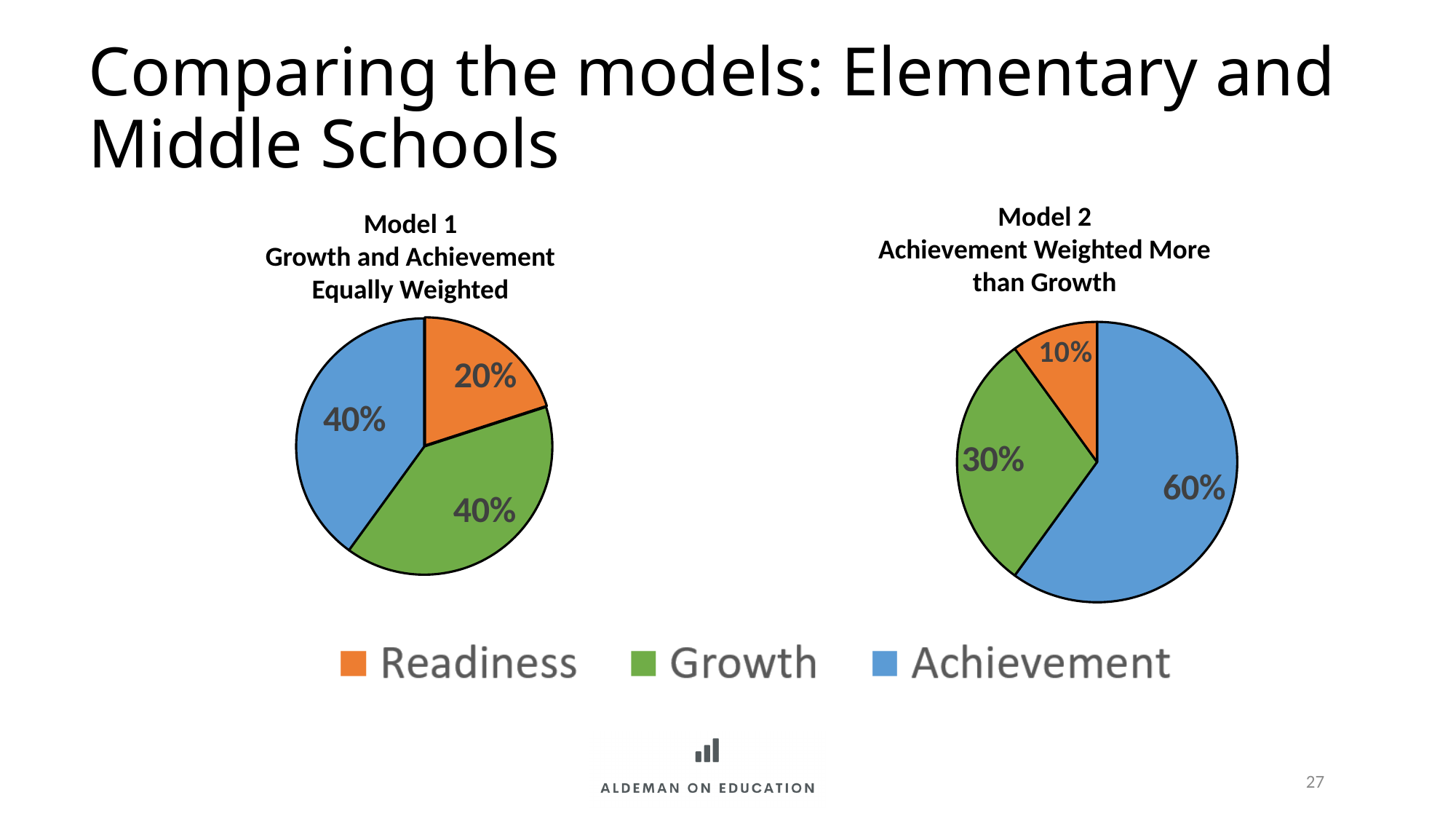
In the Model 1 pie chart, which category has the smallest slice? Readiness Which is larger: the Readiness share in Model 1 or the Readiness share in Model 2? Model 1 In the Model 2 pie chart, what share does Achievement have? 60% In the Model 2 pie chart, what is the difference between the Achievement and Growth shares? 30% What type of chart is used for Model 1 and Model 2? Pie chart In the Model 2 pie chart, which category has the largest slice? Achievement In the Model 1 pie chart, what share does Readiness have? 20% In the Model 2 pie chart, what share does Growth have? 30% Which colour represents Growth in the legend? Green In the Model 1 pie chart, what share does Growth have? 40% How many slices does the Model 1 pie chart have? 3 In the Model 2 pie chart, which category has the smallest slice? Readiness